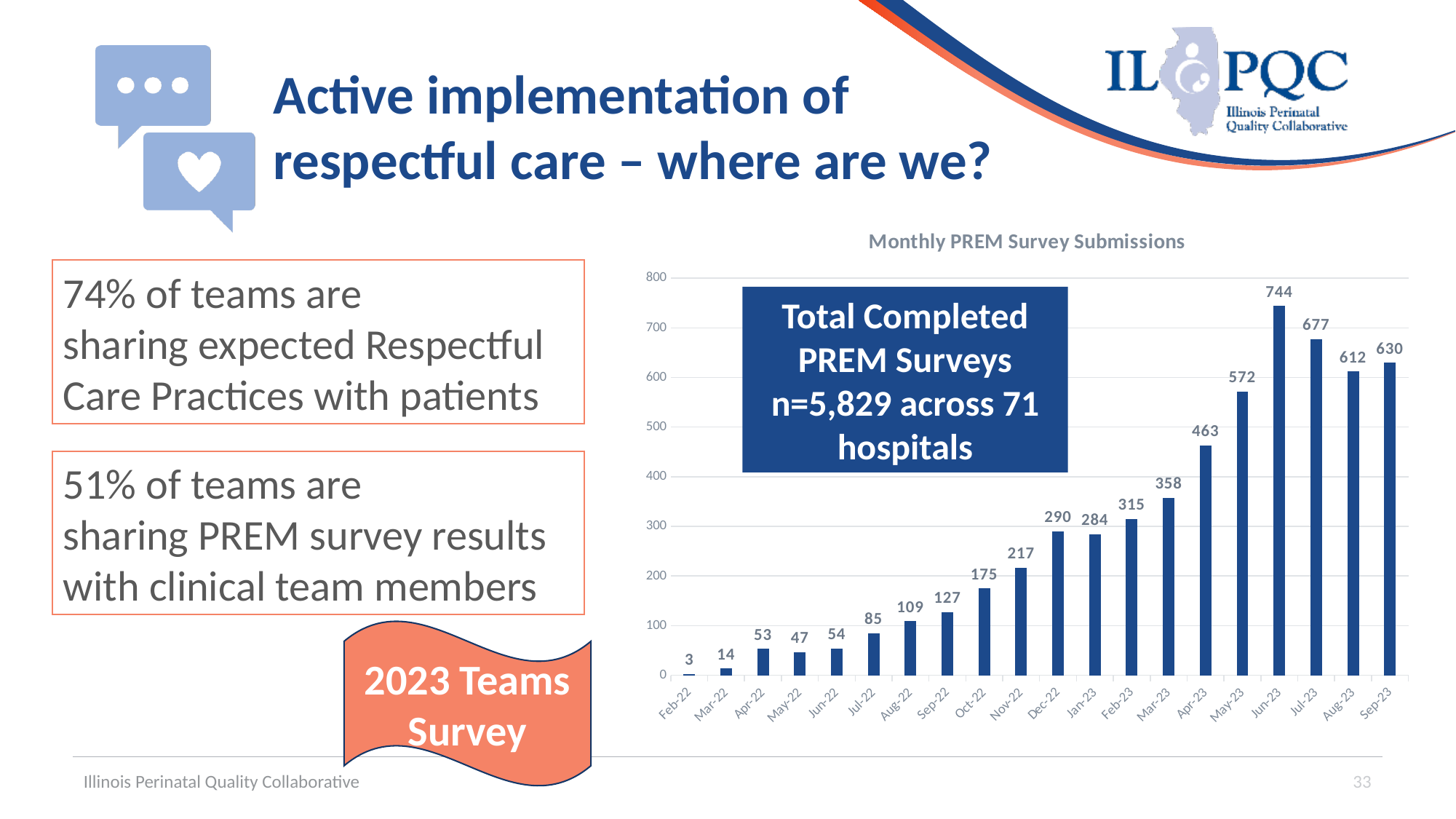
What is the value for Jun-23? 744 What is the difference between the values for Jun-23 and Jul-23? 67 What is the difference between the values for Sep-23 and Aug-23? 18 What is the title of the chart? Monthly PREM Survey Submissions What kind of chart is shown on the slide? bar chart What is the value for Dec-22? 290 What is the value for Feb-22? 3 Which month has the lowest number of submissions? Feb-22 Which is larger, the value for Apr-22 or the value for May-22? Apr-22 Do the values generally rise or fall from Feb-22 to Jun-23? rise How many monthly bars are plotted in the chart? 20 Which month has the highest number of submissions? Jun-23